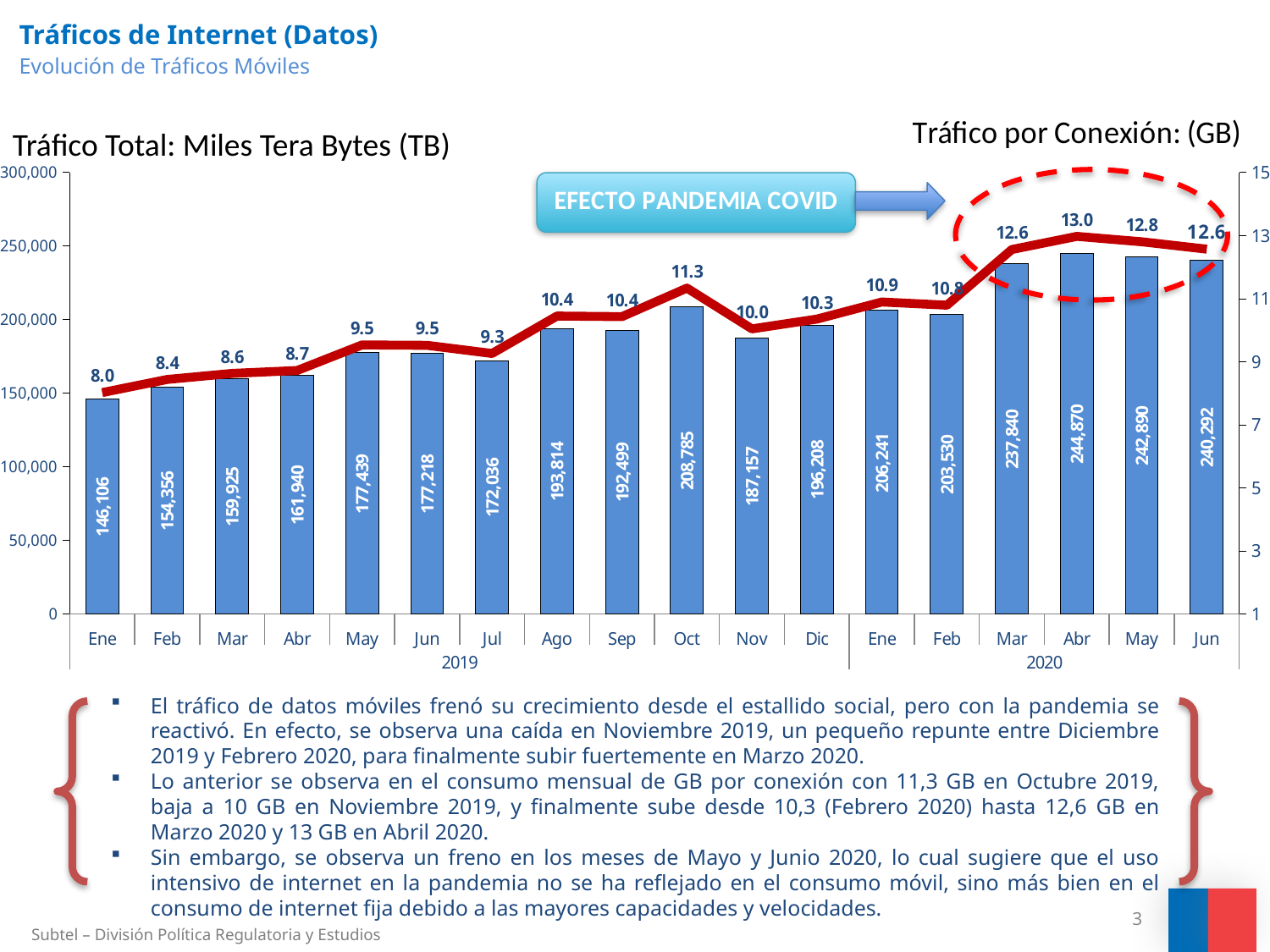
Does the traffic per connection line rise or fall from Ene 2019 to Abr 2020? rise How many months are plotted on the chart? 18 Which has higher total traffic, Oct 2019 or Nov 2019? Oct 2019 What text appears in the callout box above the chart? EFECTO PANDEMIA COVID Which month has the lowest total traffic bar? Ene 2019 What is the total mobile traffic (Miles TB) for Oct 2019? 208,785 What is the traffic per connection (GB) for Nov 2019? 10.0 What is the difference in total traffic (Miles TB) between Mar 2020 and Feb 2020? 34,310 Which month has the highest total traffic bar? Abr 2020 What is the traffic per connection (GB) for Abr 2020? 13.0 What kind of chart is used for the total traffic values? bar chart Is the total traffic bar for Jun 2019 greater or less than 200,000? less